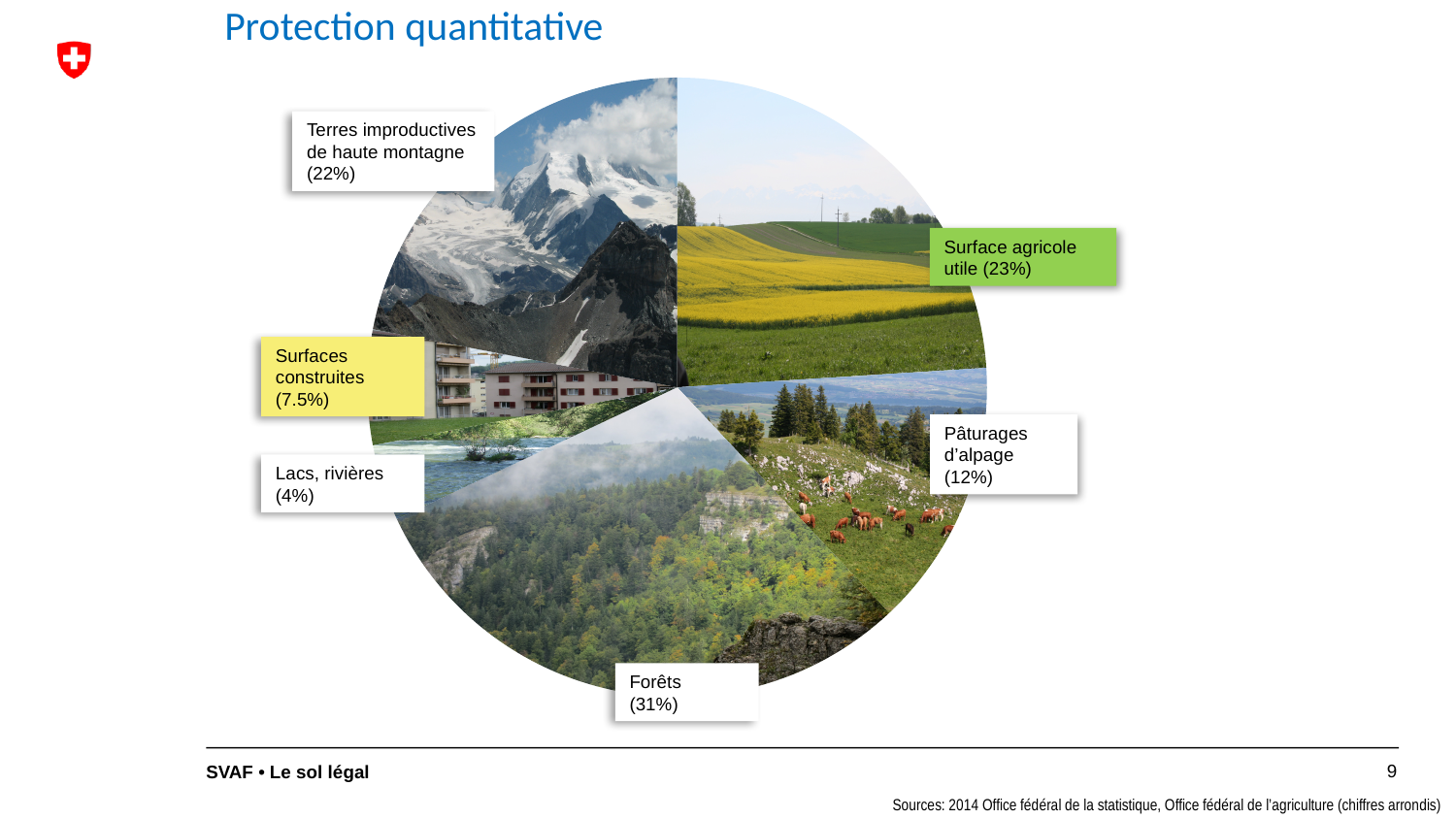
What is the difference in percentage points between Forêts and Surface agricole utile? 8 Which category has the smallest share of the pie? Lacs, rivières Which category has the largest share of the pie? Forêts What percentage is shown for Surfaces construites? 7.5% What share of the pie is labelled for Forêts? 31% How many categories does the pie chart show? 6 What percentage is shown for Surface agricole utile? 23% What kind of chart is shown on the slide? pie chart What percentage is shown for Lacs, rivières? 4% What percentage is shown for Pâturages d'alpage? 12% Which is larger, the share for Pâturages d'alpage or the share for Surfaces construites? Pâturages d'alpage What percentage is shown for Terres improductives de haute montagne? 22%